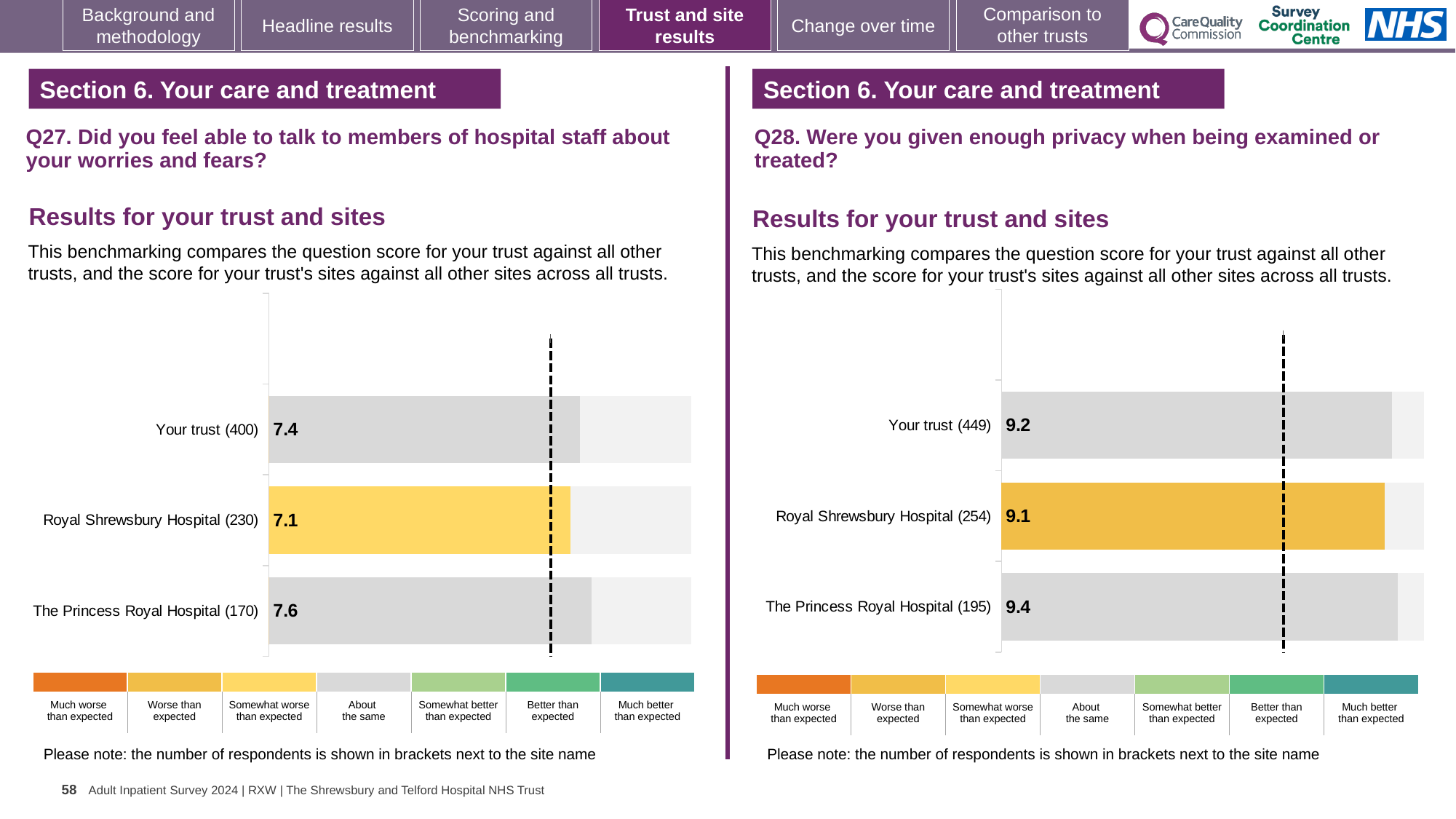
What type of chart is used on the Q27 chart (left)? bar chart On the Q28 chart (right), which site or trust has the lowest score? Royal Shrewsbury Hospital On the Q28 chart (right), what is the score for Your trust? 9.2 On the Q27 chart (left), what is the score for Royal Shrewsbury Hospital? 7.1 On the Q27 chart (left), what is the difference between the scores for The Princess Royal Hospital and Royal Shrewsbury Hospital? 0.5 On the Q27 chart (left), how many respondents are shown for Royal Shrewsbury Hospital? 230 On the Q27 chart (left), which site or trust has the lowest score? Royal Shrewsbury Hospital On the Q28 chart (right), what is the score for The Princess Royal Hospital? 9.4 On the Q28 chart (right), is the score for Your trust larger or smaller than the score for Royal Shrewsbury Hospital? larger On the Q27 chart (left), which site or trust has the highest score? The Princess Royal Hospital On the Q28 chart (right), how many bars are plotted? 3 On the Q27 chart (left), what is the score for Your trust? 7.4